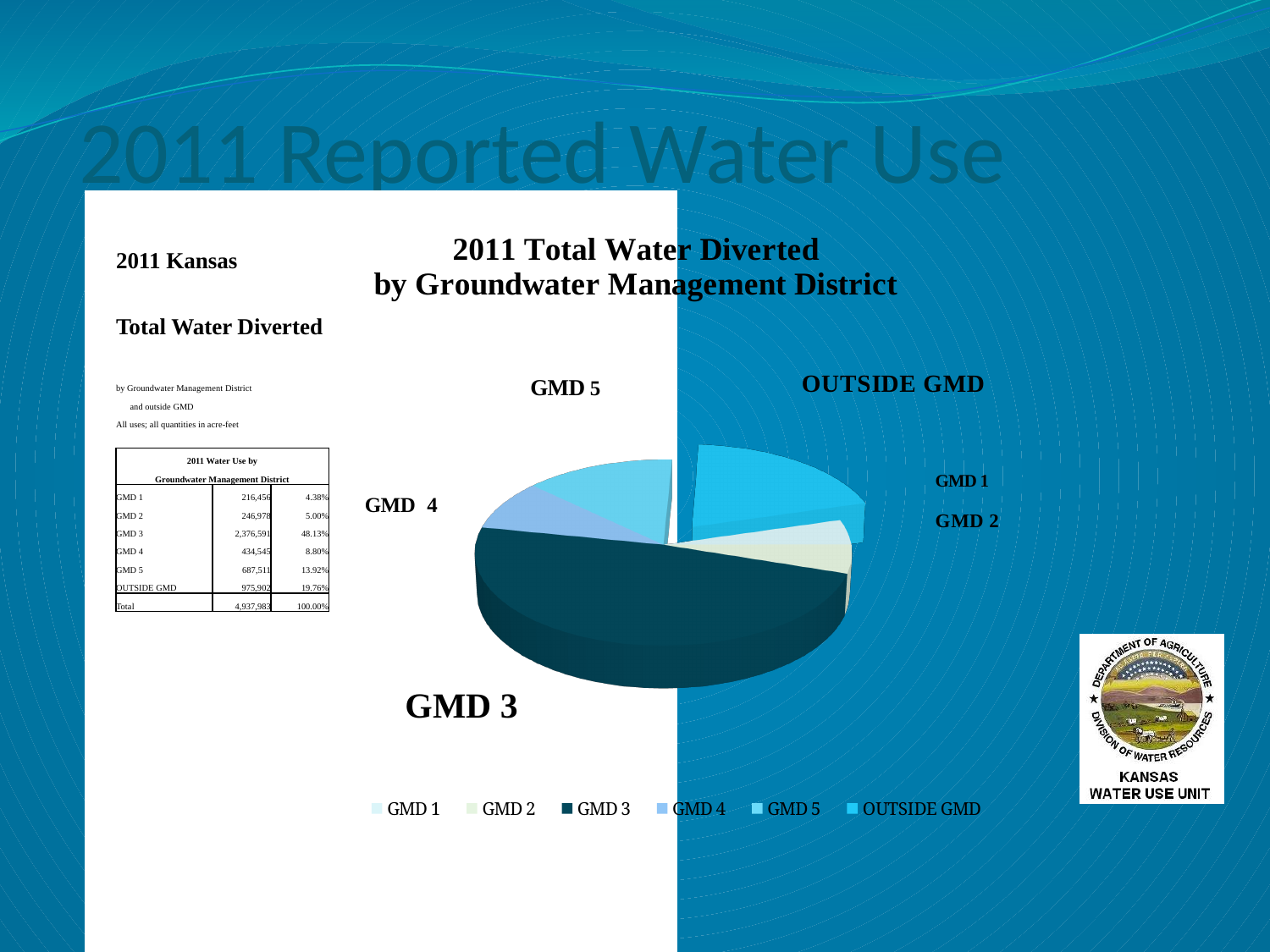
Which slice is larger, OUTSIDE GMD or GMD 5? OUTSIDE GMD According to the table on the slide, what percentage share does GMD 3 have? 48.13% How many slices does the pie chart have? 6 Which slice is larger, GMD 5 or GMD 4? GMD 5 Using the table on the slide, what is the difference in acre-feet between OUTSIDE GMD and GMD 5? 288,391 What is the title of the chart? 2011 Total Water Diverted by Groundwater Management District According to the table on the slide, which category has the smallest water use? GMD 1 According to the table on the slide, what is the water use for GMD 3 in acre-feet? 2,376,591 Which groundwater management district has the largest slice of the pie? GMD 3 How many entries does the legend list? 6 What kind of chart is shown on the slide? pie chart According to the table on the slide, what is the total water diverted in acre-feet? 4,937,983